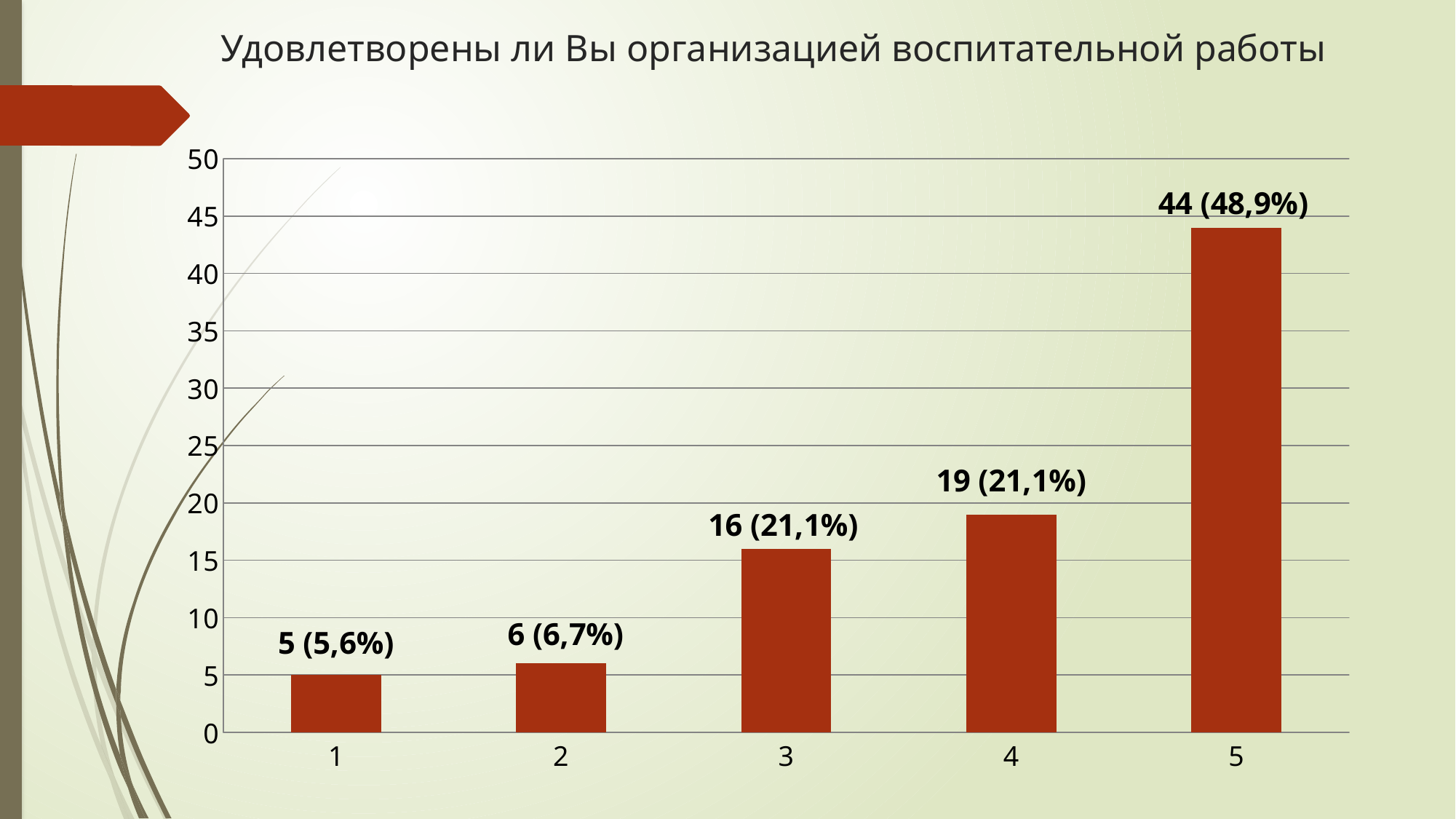
Is the value for category 5 greater or less than 40? greater What is the difference between the count for category 5 and the count for category 4? 25 How many categories are shown on the x axis? 5 What kind of chart is shown on the slide? bar chart Which category has the highest bar? 5 Which is larger, the value for category 4 or the value for category 3? 4 What is the data label shown on the bar for category 1? 5 (5,6%) What is the data label shown on the bar for category 2? 6 (6,7%) What is the data label shown on the bar for category 3? 16 (21,1%) What is the data label shown on the bar for category 5? 44 (48,9%) What is the difference between the count for category 3 and the count for category 2? 10 Which category has the lowest bar? 1